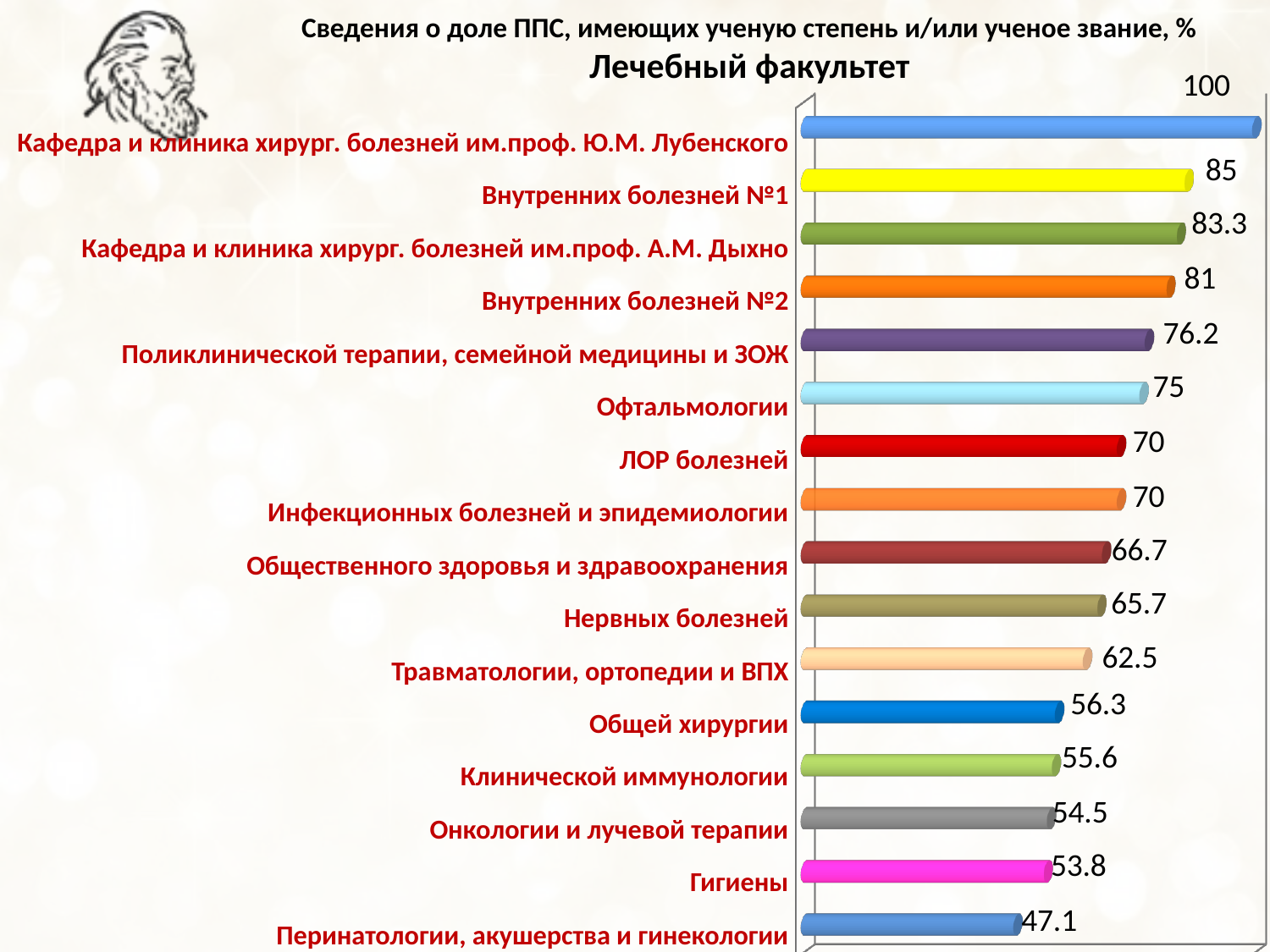
What is the value for Внутренних болезней №1? 85 What kind of chart is shown on the slide? Bar chart Which is larger, the value for Нервных болезней or the value for Общественного здоровья и здравоохранения? Общественного здоровья и здравоохранения What is the value for Офтальмологии? 75 What is the value for Травматологии, ортопедии и ВПХ? 62.5 What is the difference between the values for Внутренних болезней №1 and Внутренних болезней №2? 4 Which department has the highest value? Кафедра и клиника хирург. болезней им.проф. Ю.М. Лубенского What is the difference between the values for Общей хирургии and Перинатологии, акушерства и гинекологии? 9.2 What is the value for Гигиены? 53.8 How many departments are shown in the chart? 16 What is the title of the chart? Сведения о доле ППС, имеющих ученую степень и/или ученое звание, % Лечебный факультет Which department has the lowest value? Перинатологии, акушерства и гинекологии